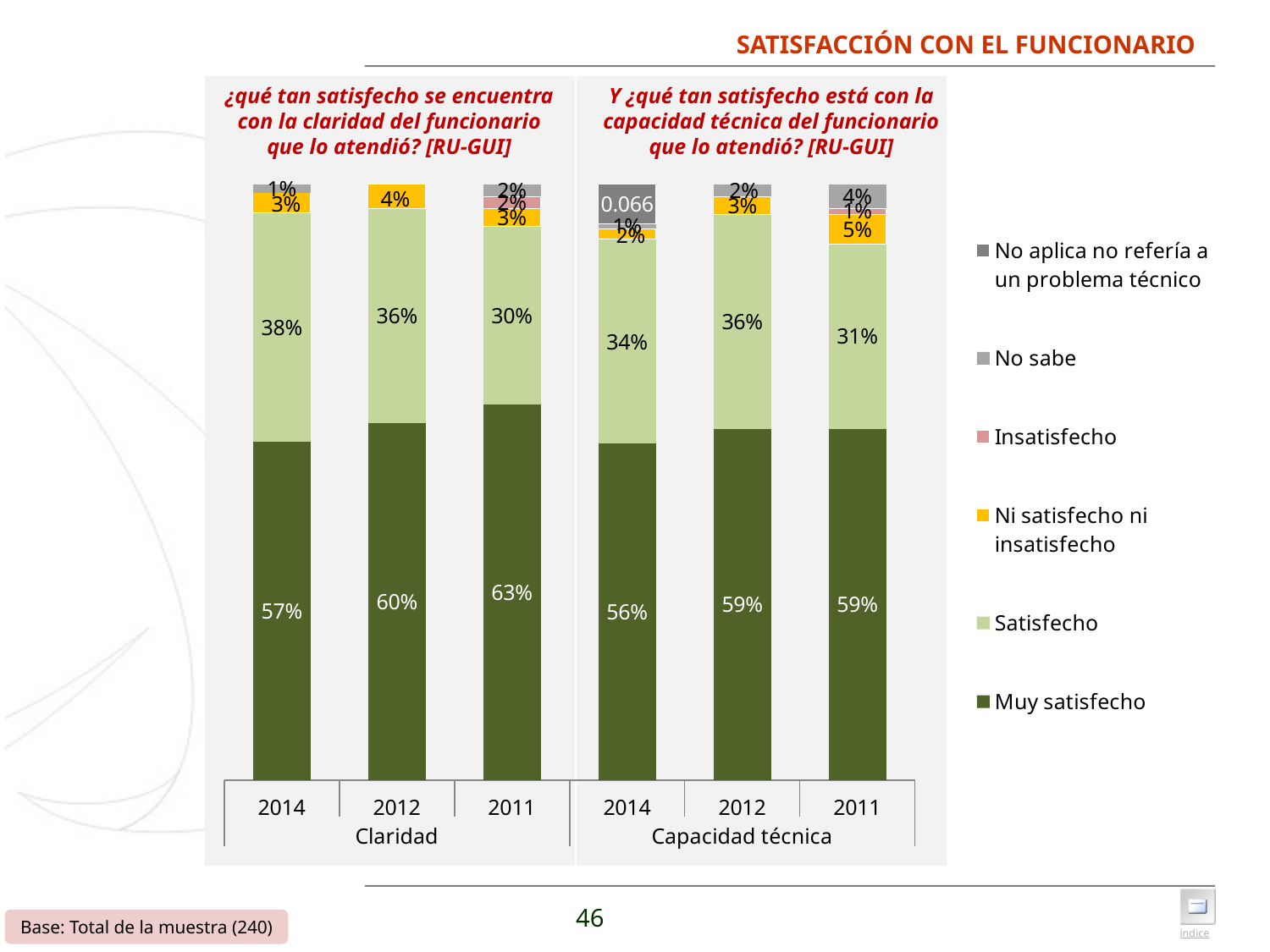
How many series does the legend list? 6 Which bar has the highest Muy satisfecho value? Claridad 2011 What kind of chart is shown on the slide? Stacked bar chart Which bar has the lowest Satisfecho value? Claridad 2011 Which is larger, the Satisfecho value for Claridad 2014 or for Capacidad técnica 2014? Claridad 2014 What is the difference between the Muy satisfecho values for Claridad in 2011 and 2014? 6% What is the Muy satisfecho value for Capacidad técnica in 2014? 56% Which legend entry is shown in dark green? Muy satisfecho What is the Muy satisfecho value for Claridad in 2014? 57% What is the Ni satisfecho ni insatisfecho value for Capacidad técnica in 2011? 5% What is the Satisfecho value for Capacidad técnica in 2012? 36% How many bars are plotted in the chart? 6